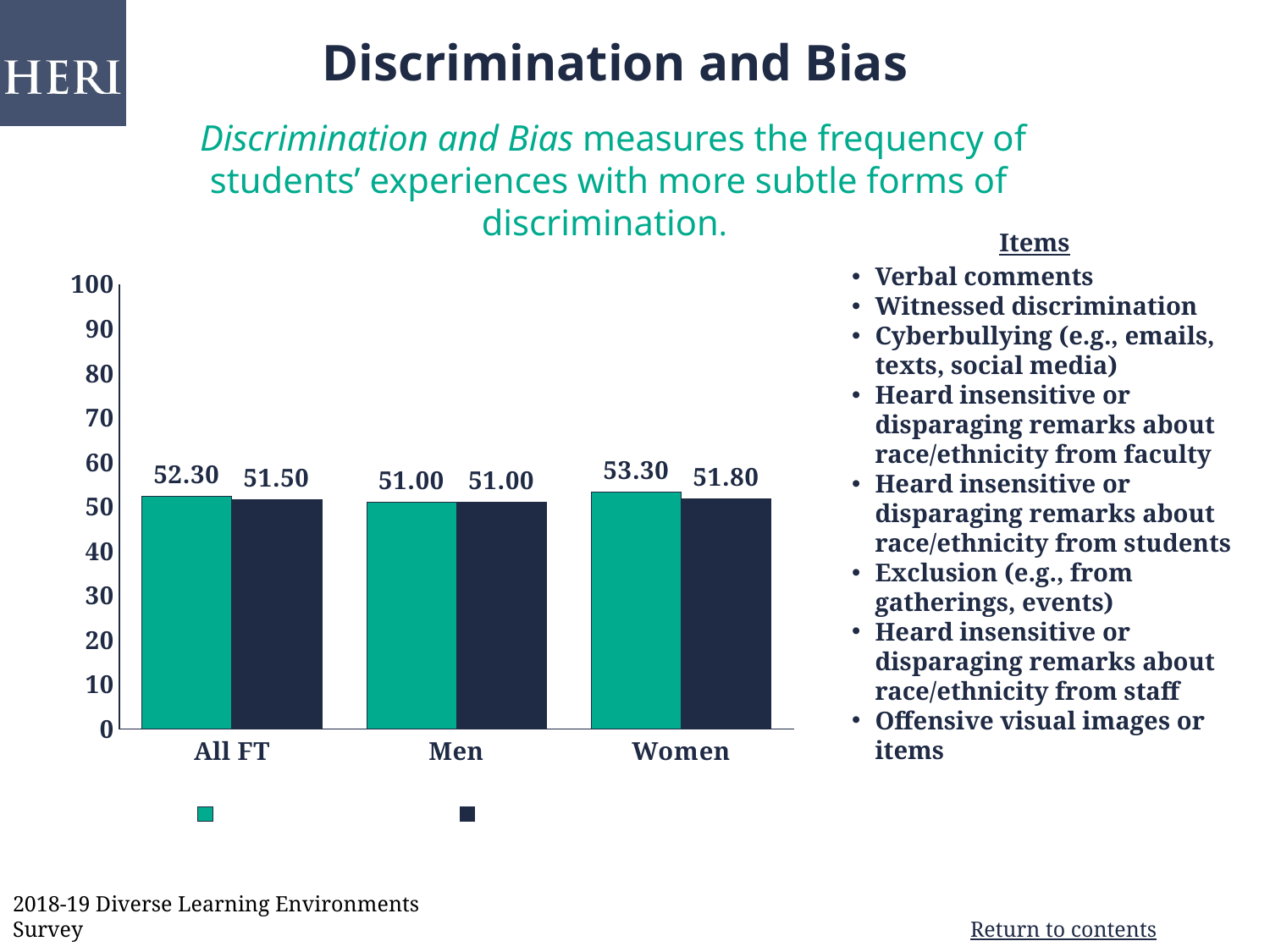
What is the difference between the teal bars for Women and All FT? 1.00 What is the value of the teal bar for All FT? 52.30 Which category has the lowest dark navy bar? Men What is the difference between the teal and dark navy bars for Women? 1.50 How many series does the chart's legend list? 2 Is the teal bar for All FT greater or less than 60? less Which category has the highest teal bar? Women What is the value of the teal bar for Men? 51.00 How many categories are shown on the x axis of the chart? 3 What kind of chart is shown on the slide? bar chart What is the value of the dark navy bar for Women? 51.80 What is the value of the dark navy bar for All FT? 51.50